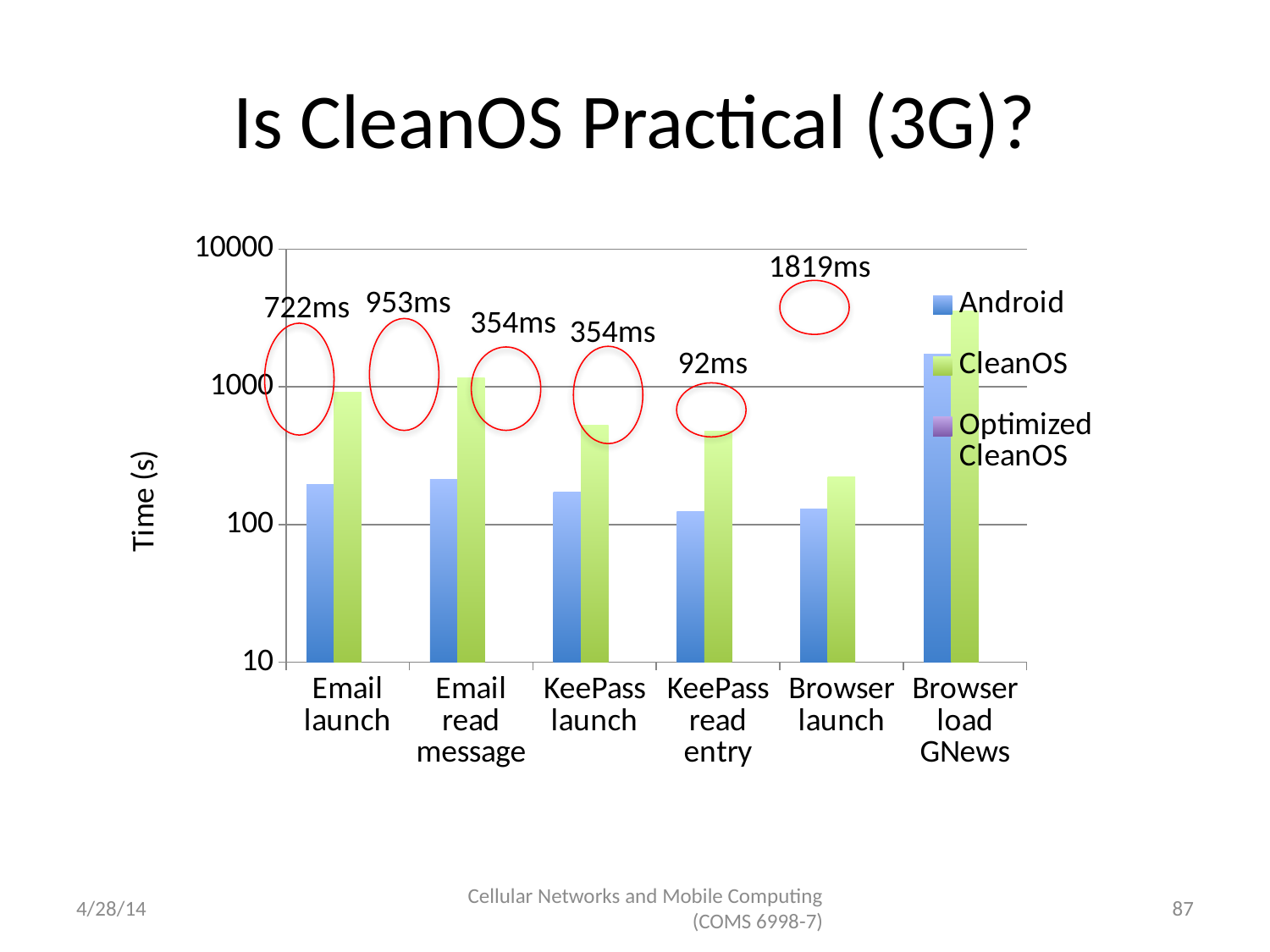
Is the CleanOS value for KeePass launch greater or less than 1000? less What kind of chart is shown on the slide? bar chart What is the label of the y axis of the chart? Time (s) How many series does the chart legend list? 3 Is the Android value for Email launch greater or less than 1000? less Is the CleanOS value for Email read message greater or less than 1000? greater How many categories are shown on the x axis of the chart? 6 For Email launch, which is larger: the Android value or the CleanOS value? CleanOS For which category is the Android bar the highest? Browser load GNews What is the title of the slide containing the chart? Is CleanOS Practical (3G)? For which category is the CleanOS bar the highest? Browser load GNews